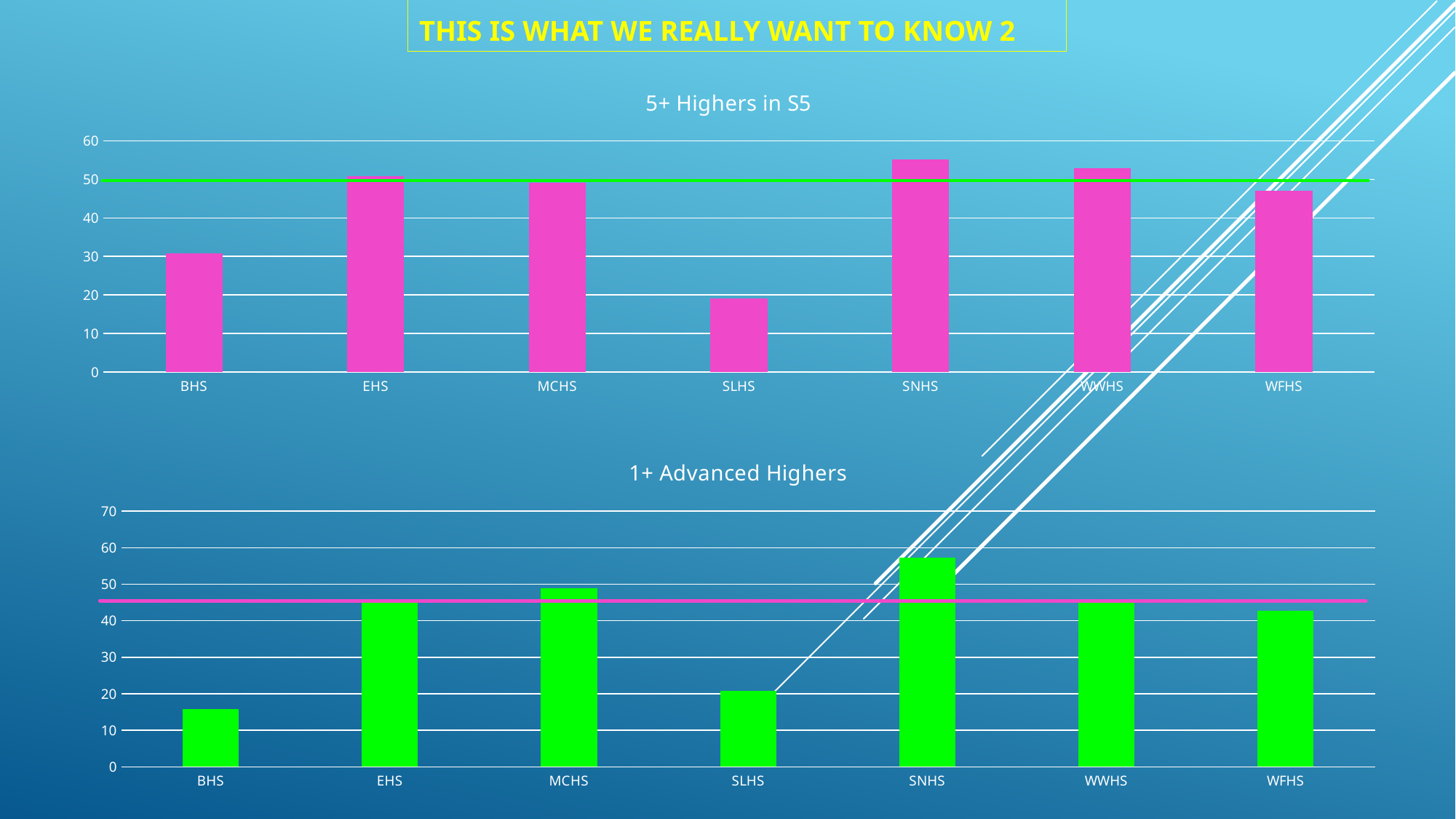
In the "1+ Advanced Highers" chart, is the value for BHS greater or less than 20? less In the "5+ Highers in S5" chart, which school has the lowest value? SLHS In the "5+ Highers in S5" chart, is the value for SLHS greater or less than 30? less What kind of chart is the top chart titled "5+ Highers in S5"? bar chart In the "1+ Advanced Highers" chart, which school has the lowest value? BHS In the "5+ Highers in S5" chart, is the value for SNHS greater or less than 50? greater In the "5+ Highers in S5" chart, how many schools are shown on the x axis? 7 In the "5+ Highers in S5" chart, which school has the highest value? SNHS In the "5+ Highers in S5" chart, which is larger, the value for BHS or the value for WFHS? WFHS What is the title of the bottom chart on the slide? 1+ Advanced Highers In the "1+ Advanced Highers" chart, which school has the highest value? SNHS